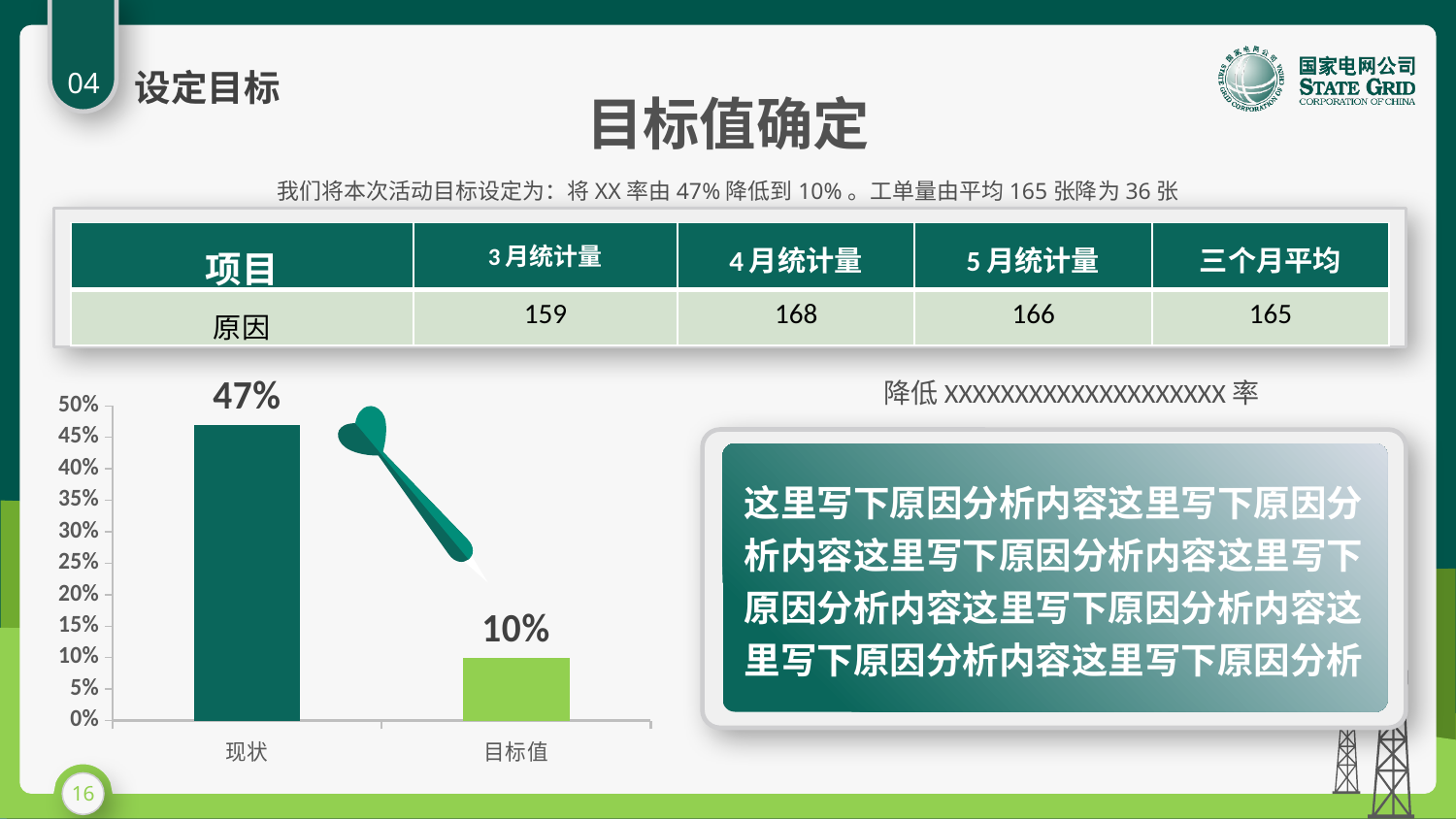
What is the value for 现状 in the bar chart? 47% What kind of chart is shown on the slide? bar chart Which category has the highest value in the bar chart? 现状 What is the highest value shown on the y axis of the bar chart? 50% Which is larger in the bar chart, the value for 现状 or the value for 目标值? 现状 Do the values rise or fall from 现状 to 目标值 along the x axis? fall What is the value for 目标值 in the bar chart? 10% What is the difference between the values for 现状 and 目标值 in the bar chart? 37% Is the value for 现状 greater or less than 40%? greater Which category has the lowest value in the bar chart? 目标值 How many categories are shown in the bar chart? 2 Is the value for 目标值 greater or less than 20%? less